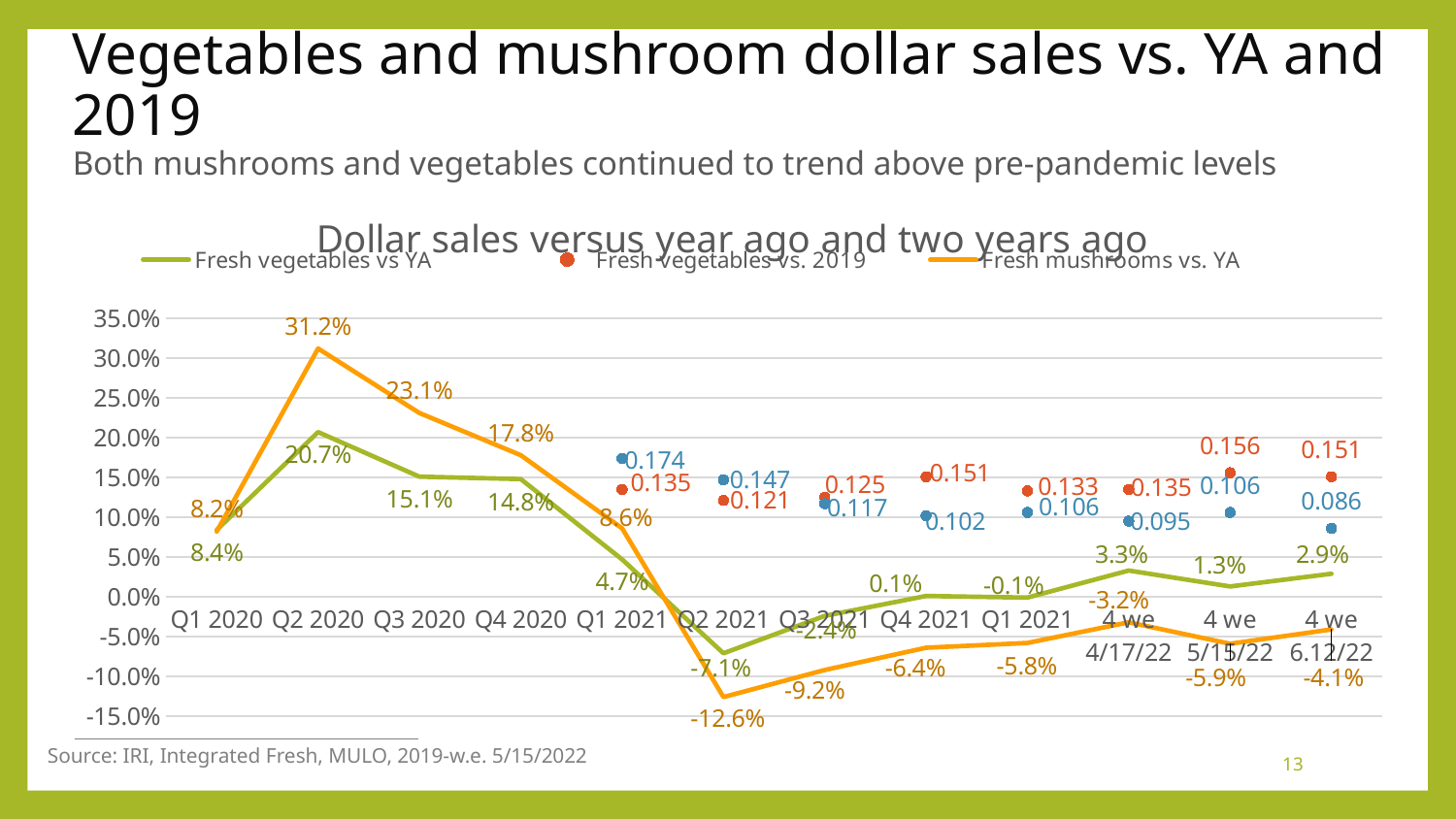
How many categories are shown along the x axis? 12 Does Fresh vegetables vs YA rise or fall from Q2 2020 to Q2 2021? Fall What is the value for Fresh vegetables vs YA in Q2 2020? 20.7% In which period is Fresh vegetables vs YA lowest? Q2 2021 How many series does the chart legend list? 3 In which period is Fresh mushrooms vs. YA highest? Q2 2020 What kind of chart is shown on the slide? Line chart What is the title of the chart? Dollar sales versus year ago and two years ago In Q2 2020, how many percentage points higher is Fresh mushrooms vs. YA than Fresh vegetables vs YA? 10.5 percentage points In which period is Fresh mushrooms vs. YA lowest? Q2 2021 What is the value for Fresh mushrooms vs. YA in Q4 2020? 17.8% What is the value for Fresh vegetables vs. 2019 in the 4 we 5/15/22 period? 0.156